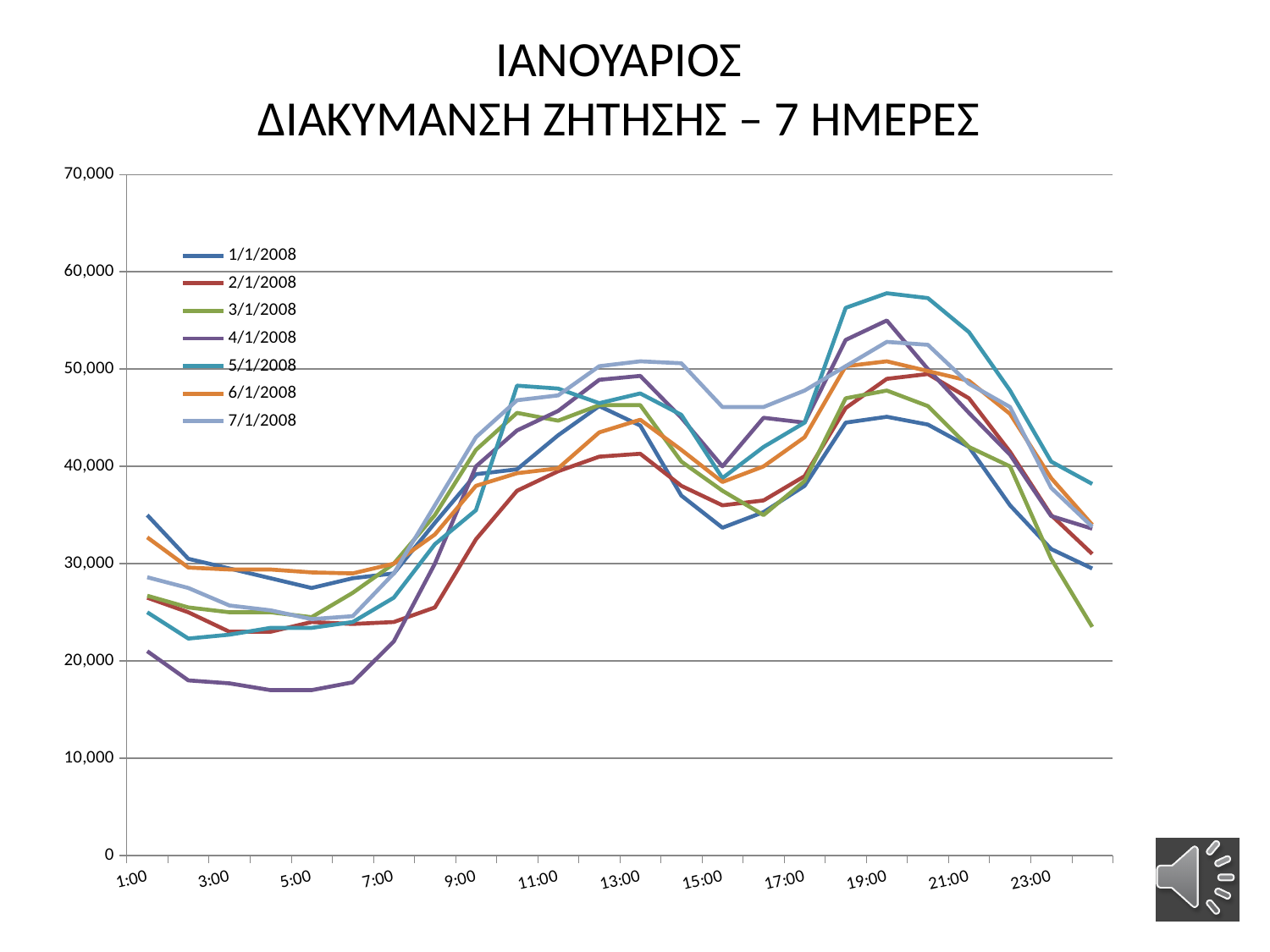
At 19:00, which series has the larger value, 5/1/2008 or 1/1/2008? 5/1/2008 Which series has the lowest value at 5:00? 4/1/2008 What kind of chart is shown on the slide? line chart How many series does the legend list? 7 Do the values for 5/1/2008 rise or fall between 7:00 and 11:00? rise Is the value for 5/1/2008 at 19:00 greater or less than 50,000? greater What is the title of the chart? ΙΑΝΟΥΑΡΙΟΣ ΔΙΑΚΥΜΑΝΣΗ ΖΗΤΗΣΗΣ – 7 ΗΜΕΡΕΣ Is the value for 4/1/2008 at 5:00 greater or less than 20,000? less At 1:00, which series has the larger value, 1/1/2008 or 4/1/2008? 1/1/2008 Which series reaches the highest value on the chart? 5/1/2008 Is the value for 1/1/2008 at 1:00 greater or less than 30,000? greater Which date is listed first in the legend? 1/1/2008